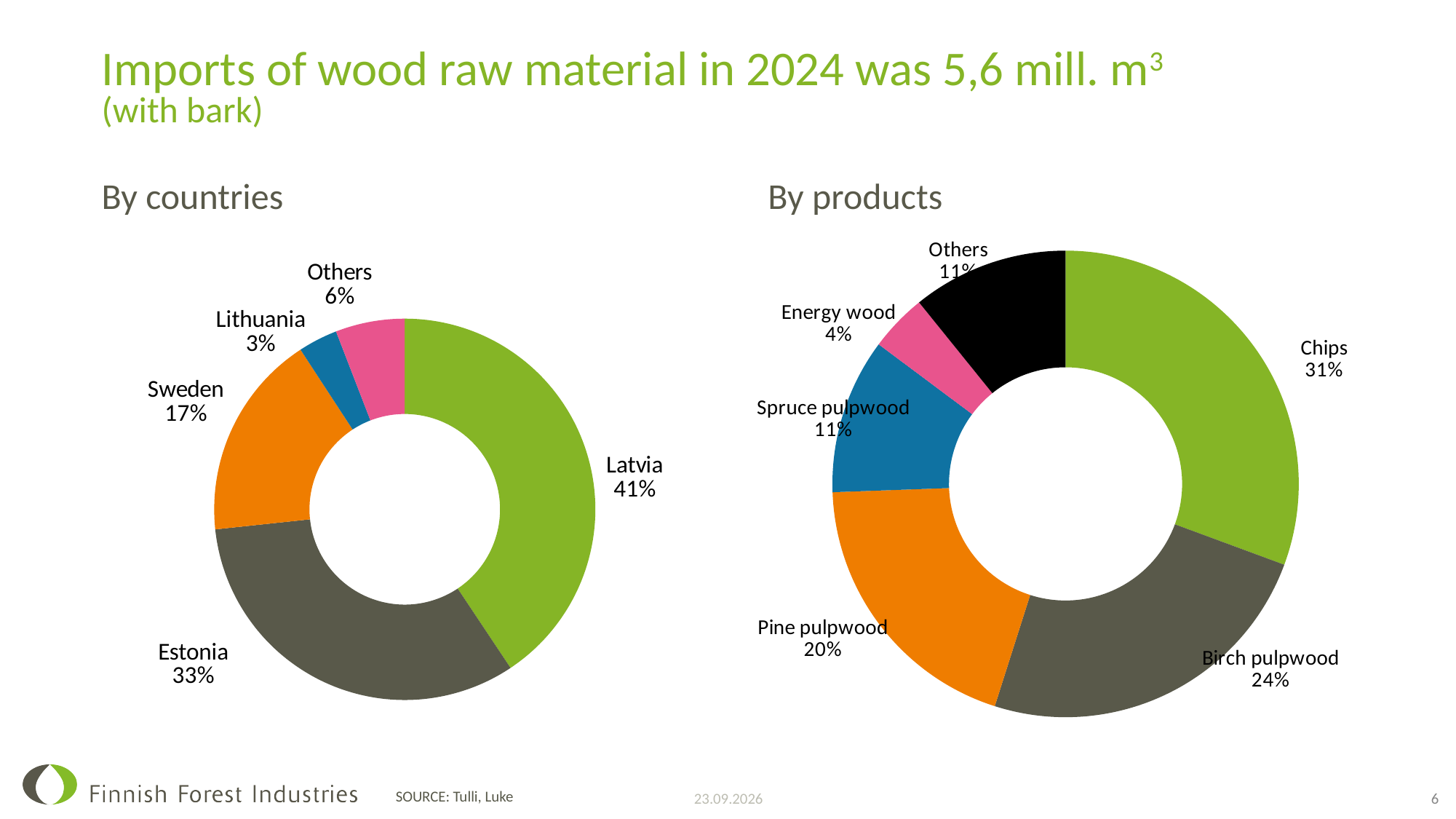
In the 'By countries' chart, what share of imports comes from Sweden? 17% In the 'By products' chart, how many slices are shown? 6 In the 'By products' chart, which product has the largest share? Chips In the 'By products' chart, which is larger, Pine pulpwood or Spruce pulpwood? Pine pulpwood In the 'By countries' chart, how many slices are shown? 5 What type of chart is used for the 'By countries' data? Doughnut chart In the 'By products' chart, what share of imports is Birch pulpwood? 24% In the 'By countries' chart, what is the difference in percentage points between Latvia and Estonia? 8 In the 'By countries' chart, which country has the largest share? Latvia In the 'By products' chart, what share of imports is Energy wood? 4% In the 'By countries' chart, which category has the smallest share? Lithuania In the 'By countries' chart, what share of imports comes from Latvia? 41%